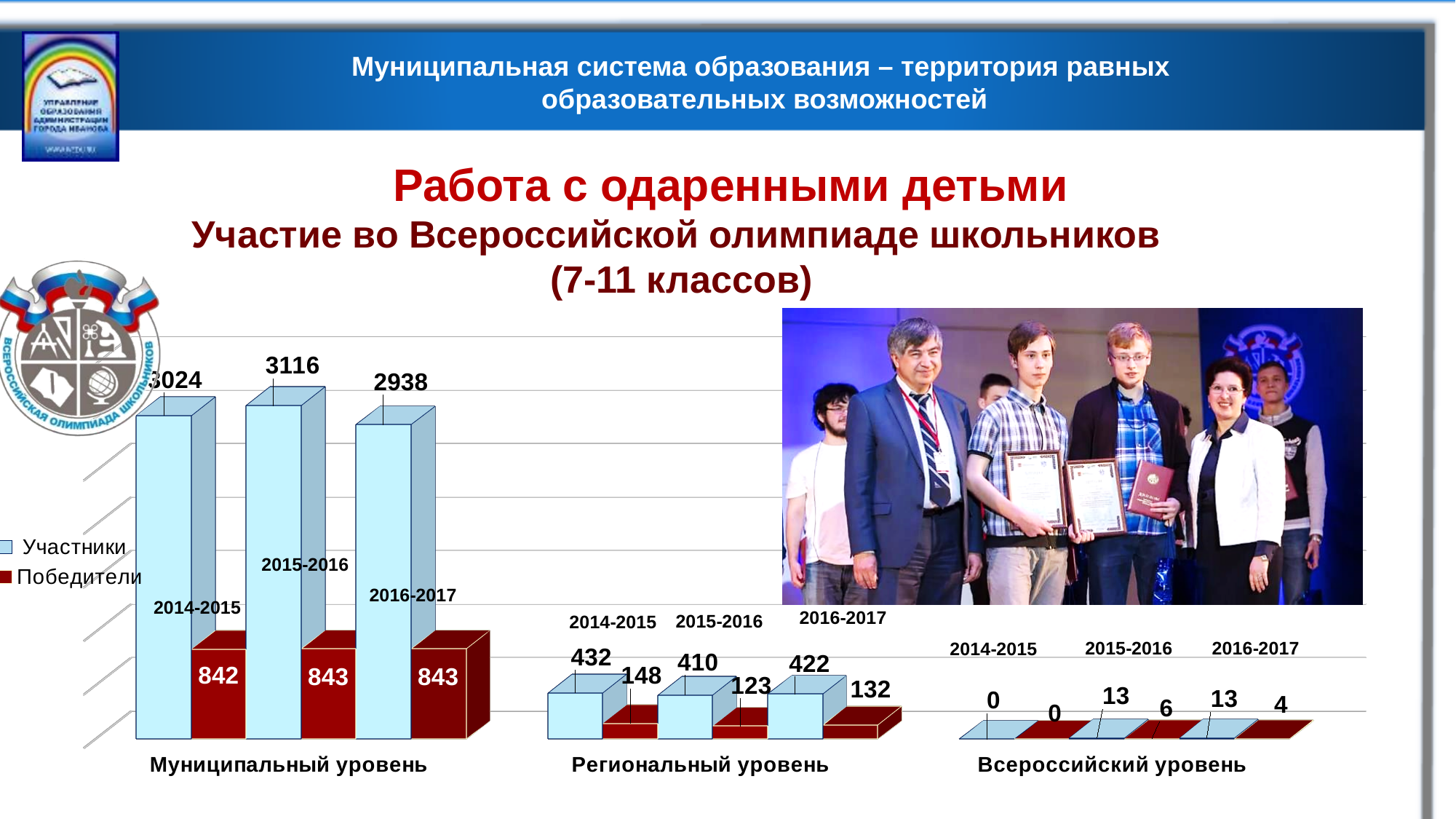
How many participants (Участники) were there at the all-Russian level (Всероссийский уровень) in 2014-2015? 0 What kind of chart is shown on the slide? Bar chart What is the difference between the number of regional-level participants in 2014-2015 and in 2015-2016? 22 How many participants (Участники) were there at the municipal level (Муниципальный уровень) in 2015-2016? 3116 How many series does the legend list? 2 How many winners (Победители) were there at the all-Russian level (Всероссийский уровень) in 2016-2017? 4 Which year had the fewest participants (Участники) at the regional level (Региональный уровень)? 2015-2016 How many winners (Победители) were there at the regional level (Региональный уровень) in 2014-2015? 148 Which year had more winners (Победители) at the regional level: 2014-2015 or 2016-2017? 2014-2015 By how much did the number of municipal-level winners (Победители) in 2016-2017 exceed that in 2014-2015? 1 How many participants (Участники) were there at the municipal level (Муниципальный уровень) in 2016-2017? 2938 Which year had the most participants (Участники) at the municipal level (Муниципальный уровень)? 2015-2016